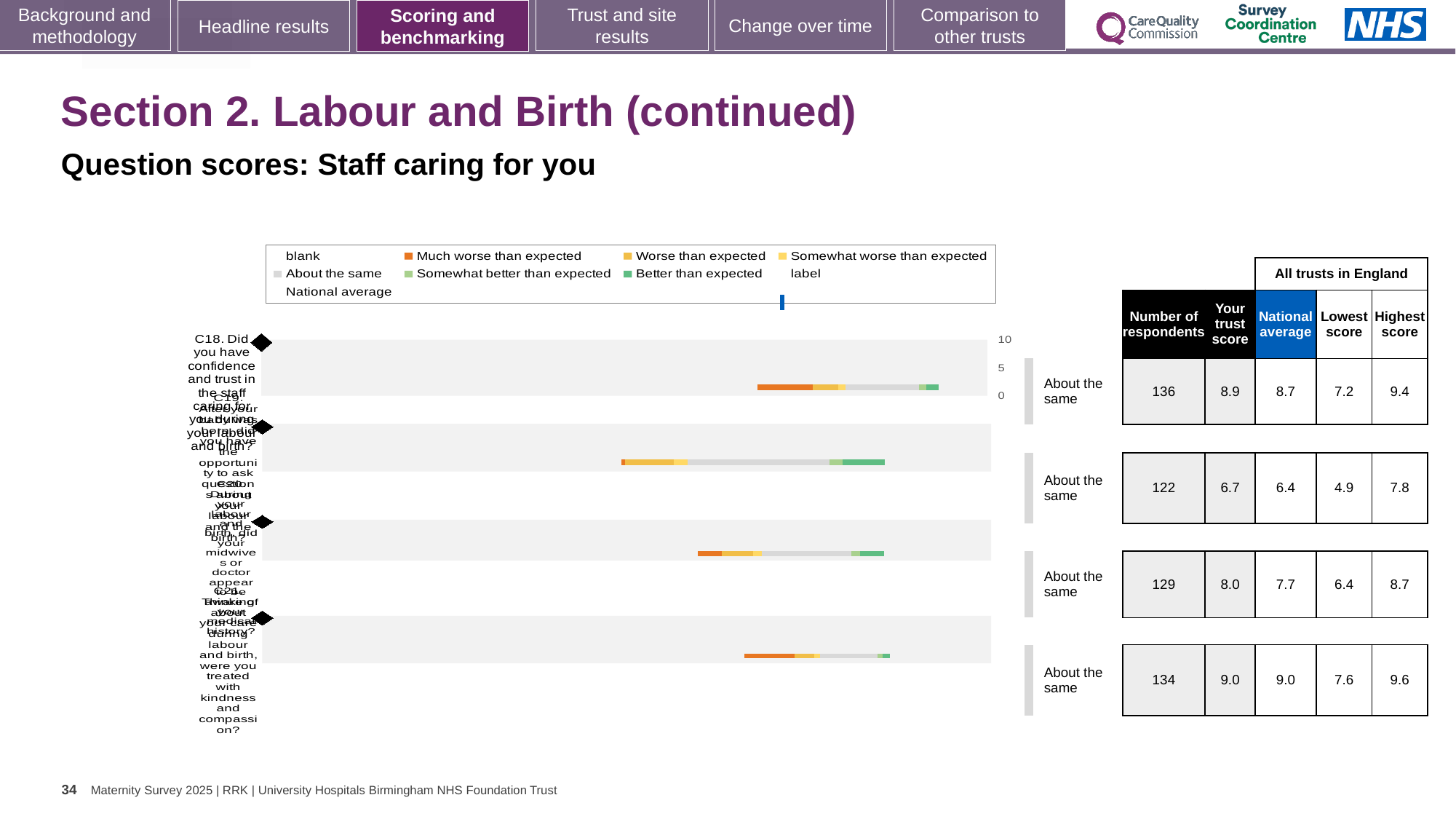
For question C18, what is the difference between the trust score and the national average? 0.2 In the table, what is the number of respondents for question C18 (the first row)? 136 In the table, what is the highest score for question C21 (the last row)? 9.6 How many questions (bars) are plotted in the chart? 4 What benchmark category is shown for all four questions? About the same Which row of the table has the highest number of respondents? the first row, C18 (136) In the table, what is the lowest score for the second row? 4.9 In the table, what is the national average for question C21 (the last row)? 9.0 What kind of chart is shown on the slide? bar chart For question C18, is the trust score or the national average larger? the trust score (8.9) Which row of the table has the lowest trust score? the second row (6.7) In the table, what is the trust score for question C18 (the first row)? 8.9